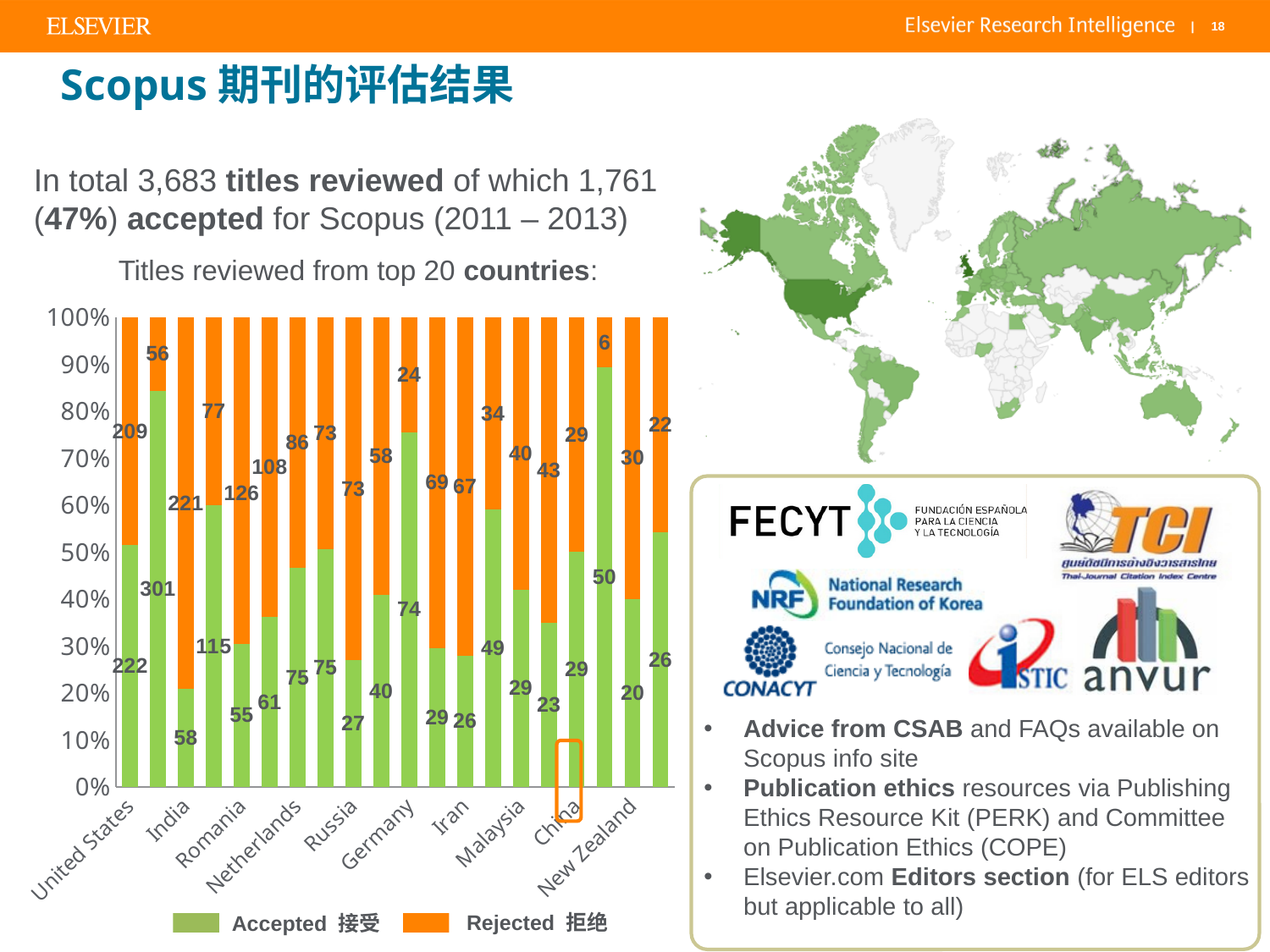
How many rejected titles are shown for New Zealand? 30 What are the two series named in the chart legend? Accepted and Rejected How many rejected titles are shown for India? 221 How many accepted titles are shown for the United States? 222 Which has more accepted titles, Romania or Netherlands? Netherlands How many series does the chart legend list? 2 What type of chart is shown on the slide? Stacked bar chart What is the difference between the accepted counts for the United States and India? 164 What is the total number of titles reviewed for Iran (accepted plus rejected)? 93 Is the accepted share for Germany greater or less than 70%? greater How many accepted titles are shown for Germany? 74 What is the total number of titles reviewed for the United States (accepted plus rejected)? 431